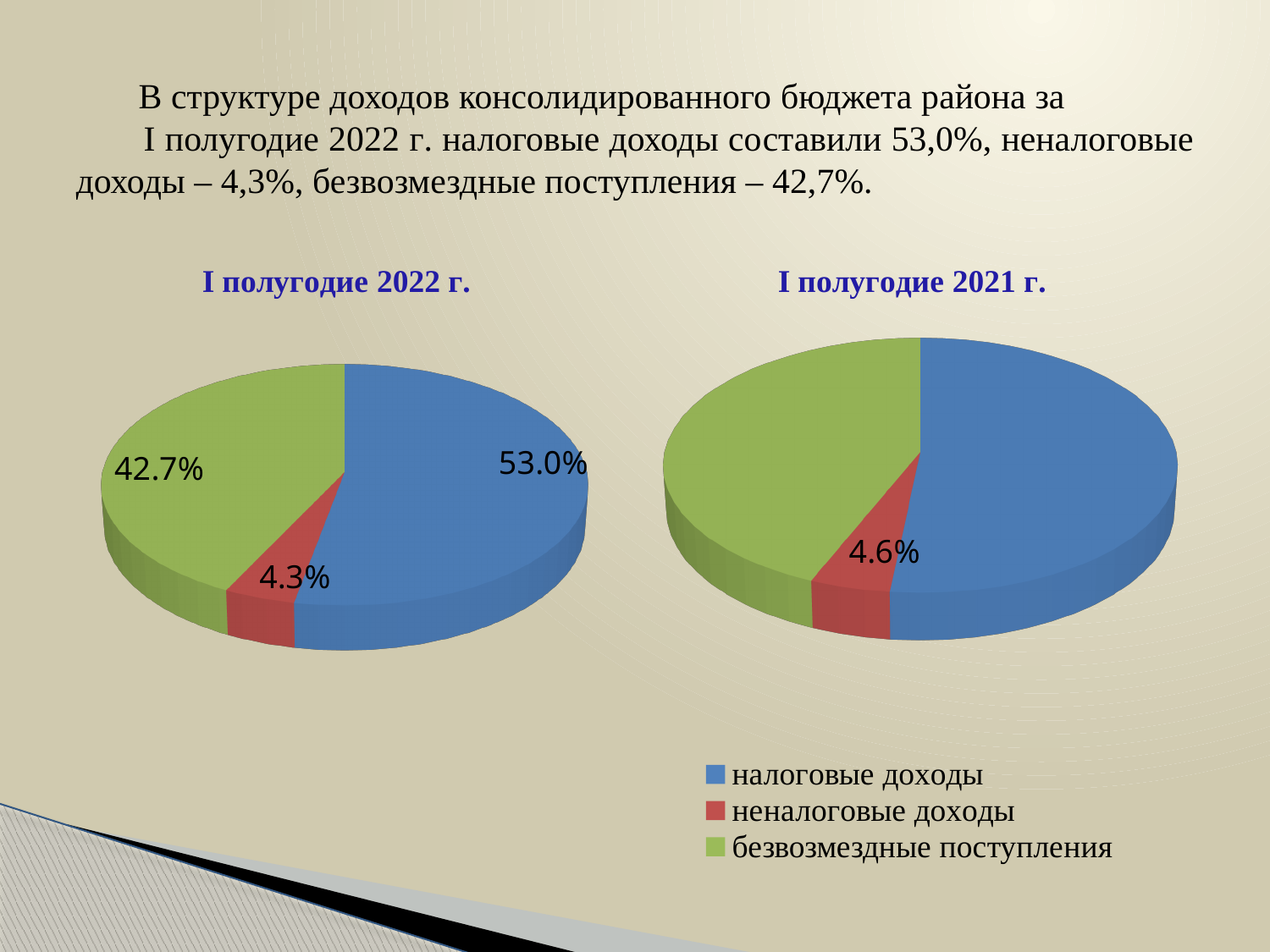
In the chart titled "I полугодие 2022 г.", what share is shown for налоговые доходы? 53.0% In the chart titled "I полугодие 2022 г.", what share is shown for безвозмездные поступления? 42.7% In the chart titled "I полугодие 2021 г.", which category has the smallest share? неналоговые доходы How many categories does the legend list for the charts on the slide? 3 In the chart titled "I полугодие 2022 г.", which category has the smallest share? неналоговые доходы In the chart titled "I полугодие 2022 г.", which category has the largest share? налоговые доходы In the chart titled "I полугодие 2021 г.", what share is shown for неналоговые доходы? 4.6% In the chart titled "I полугодие 2022 г.", what share is shown for неналоговые доходы? 4.3% According to the legend, which colour represents безвозмездные поступления? green What type of chart is the one titled "I полугодие 2021 г."? pie chart In the chart titled "I полугодие 2021 г.", which is larger: the share of безвозмездные поступления or the share of неналоговые доходы? безвозмездные поступления In the chart titled "I полугодие 2022 г.", what is the difference between the shares of налоговые доходы and безвозмездные поступления? 10.3%